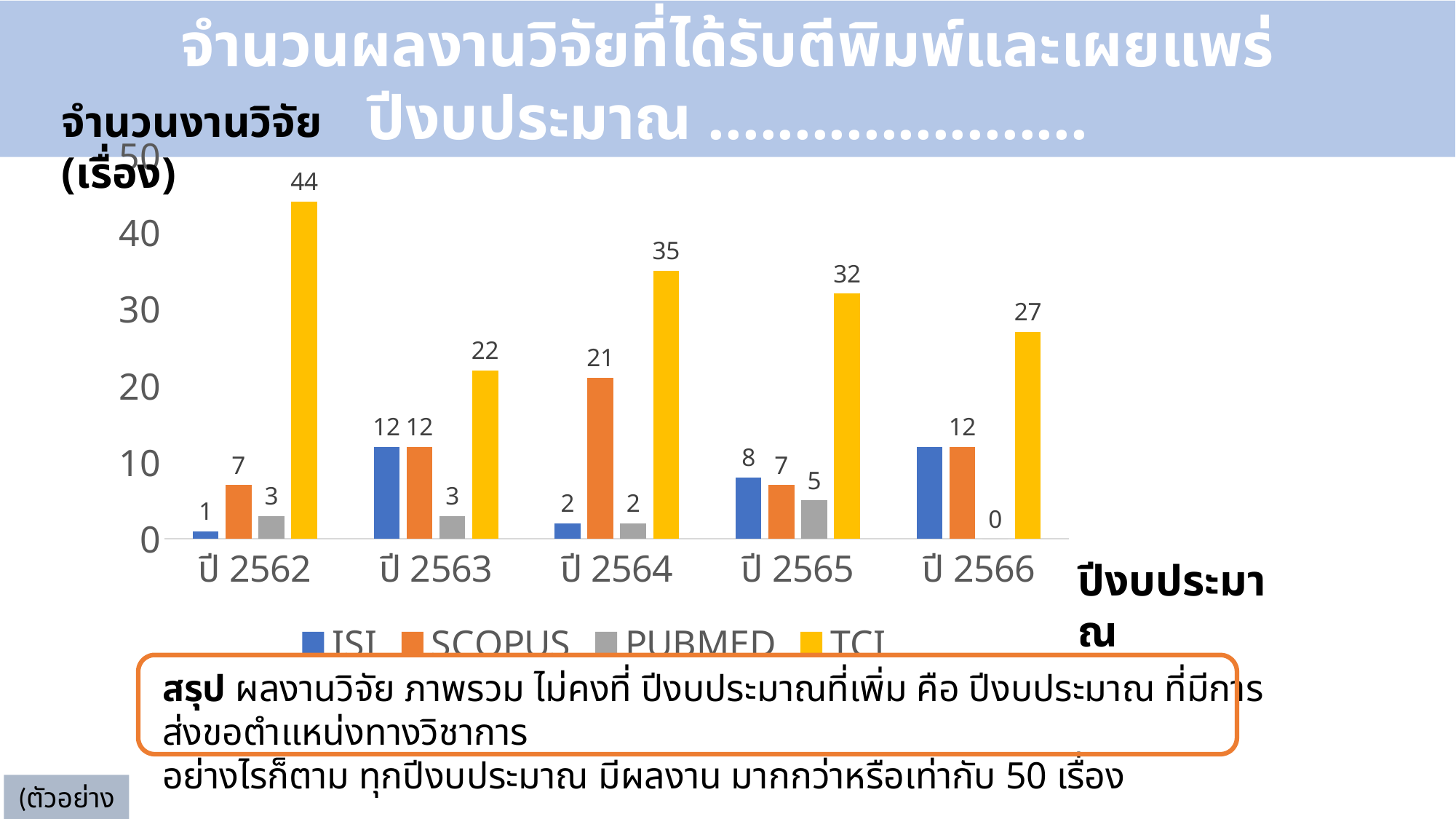
What is the difference between the TCI values for ปี 2564 and ปี 2565? 3 What is the PUBMED value for ปี 2566? 0 What is the ISI value for ปี 2565? 8 In which year is the ISI value lowest? ปี 2562 Which series is shown in yellow in the legend? TCI In which year is the TCI value highest? ปี 2562 How many years (categories) are shown on the x axis? 5 Which is larger, the SCOPUS value for ปี 2564 or the SCOPUS value for ปี 2563? ปี 2564 What kind of chart is shown on the slide? Bar chart How many series does the legend list? 4 What is the SCOPUS value for ปี 2564? 21 What is the TCI value for ปี 2562? 44